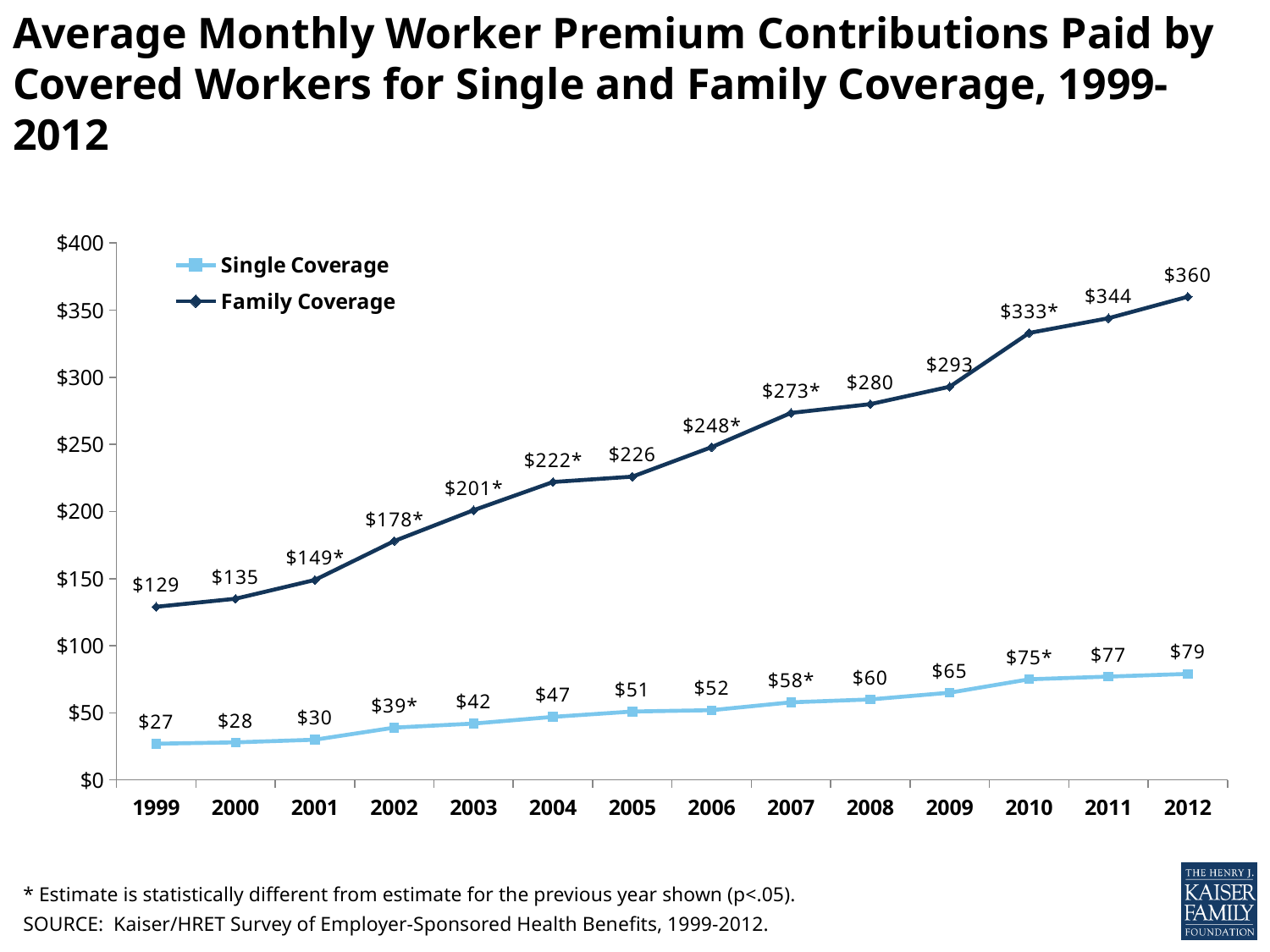
Do the Single Coverage values rise or fall from 1999 to 2012? Rise What is the Family Coverage value for 2004? $222* What kind of chart is shown on the slide? Line chart What is the Single Coverage value for 1999? $27 Which year has the highest Family Coverage value? 2012 How many series does the legend list? 2 Which is larger, the Family Coverage value in 2008 or in 2009? 2009 What is the Family Coverage value for 2012? $360 How many years are shown on the x axis? 14 Which year has the lowest Single Coverage value? 1999 What is the difference between the Family Coverage and Single Coverage values in 2012? $281 What is the Single Coverage value for 2010? $75*